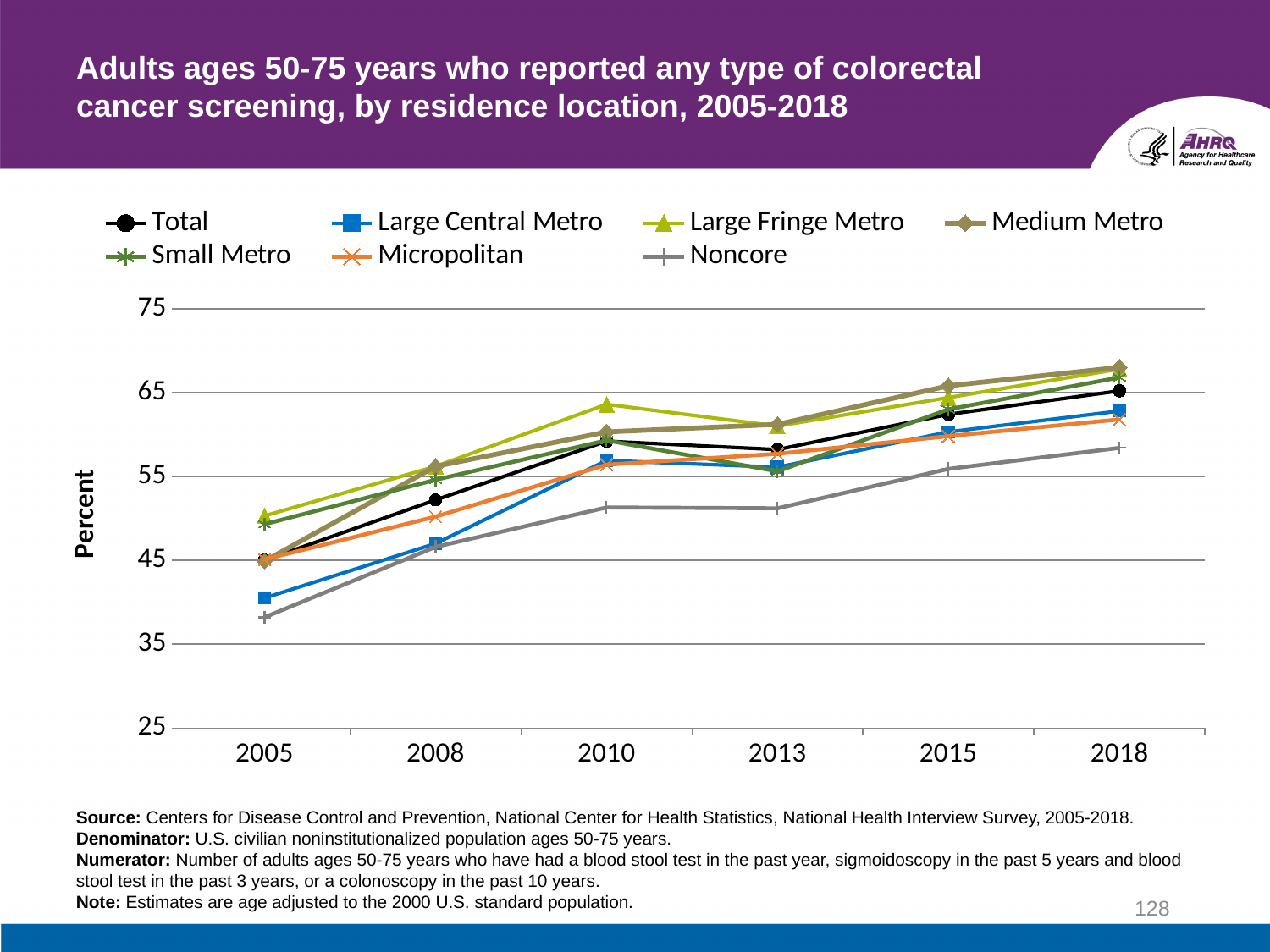
Which residence location has the lowest value in 2005? Noncore In 2013, which is larger: the value for Large Central Metro or the value for Noncore? Large Central Metro Which residence location has the lowest value in 2018? Noncore What kind of chart is shown on the slide? Line chart Is the value for Medium Metro in 2018 greater or less than 65? greater Is the value for Noncore in 2013 greater or less than 55? less How many series does the legend list? 7 Does the Total line rise or fall from 2005 to 2018? Rises What is the label on the y axis? Percent Is the value for Noncore in 2005 greater or less than 45? less Which residence location has the highest value in 2010? Large Fringe Metro How many years are plotted along the x axis? 6